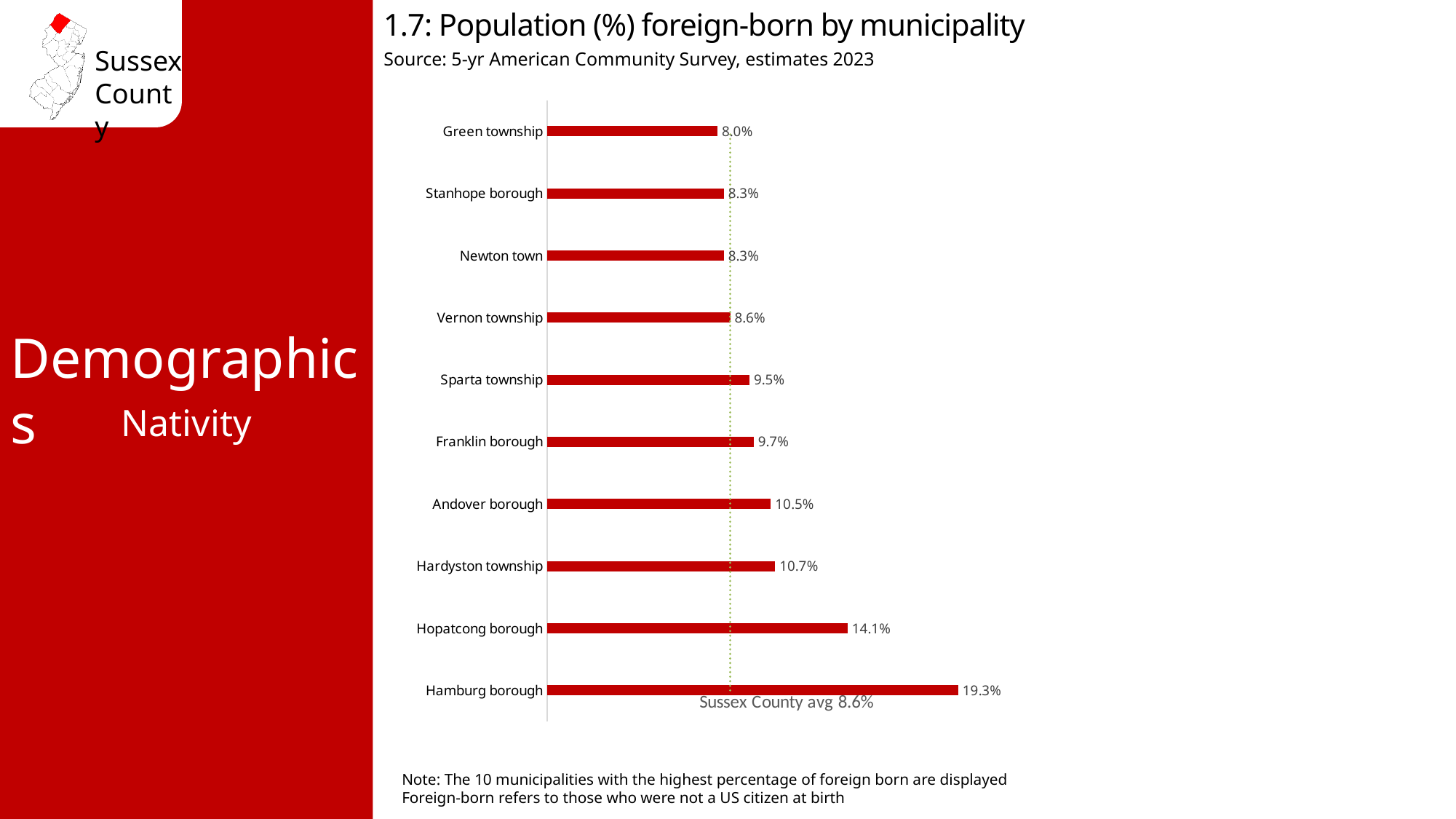
What is the source of the data shown in the chart? 5-yr American Community Survey, estimates 2023 What is the foreign-born population percentage for Sparta township? 9.5% What is the foreign-born population percentage for Hardyston township? 10.7% What is the foreign-born population percentage for Hamburg borough? 19.3% How many municipalities are shown on the chart? 10 What is the difference in foreign-born percentage between Hamburg borough and Hopatcong borough? 5.2% Which municipality has the highest foreign-born population percentage? Hamburg borough What is the difference in foreign-born percentage between Andover borough and Green township? 2.5% Which has a higher foreign-born percentage, Franklin borough or Vernon township? Franklin borough What type of chart is used on this slide? Bar chart What is the Sussex County average foreign-born percentage indicated by the dotted line? 8.6% Which municipality has the lowest foreign-born population percentage shown on the chart? Green township